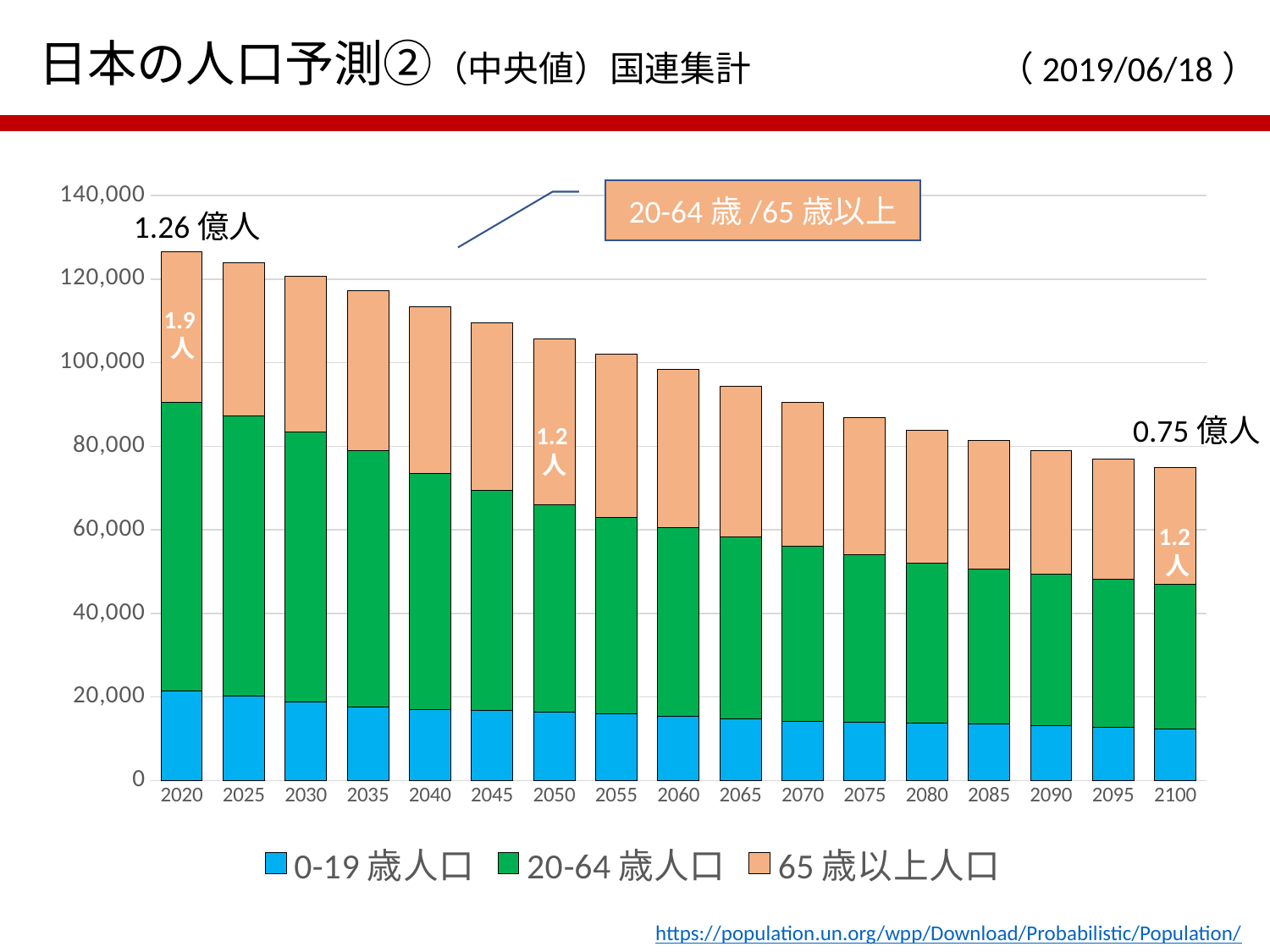
What ratio of 20-64 歳 to 65 歳以上 is labelled on the 2020 bar? 1.9 人 What kind of chart is shown on the slide? Stacked bar chart How many years (categories) are plotted along the x axis? 17 Which is larger, the 20-64 歳人口 segment in 2020 or in 2100? 2020 Is the total population for 2050 greater or less than 100,000? greater Which year has the lowest total population? 2100 Which year has the highest total population? 2020 How many series does the legend list? 3 What total population is labelled for 2100? 0.75 億人 Is the total population for 2100 greater or less than 80,000? less What total population is labelled for 2020? 1.26 億人 Do the total bar heights rise or fall from 2020 to 2100? Fall